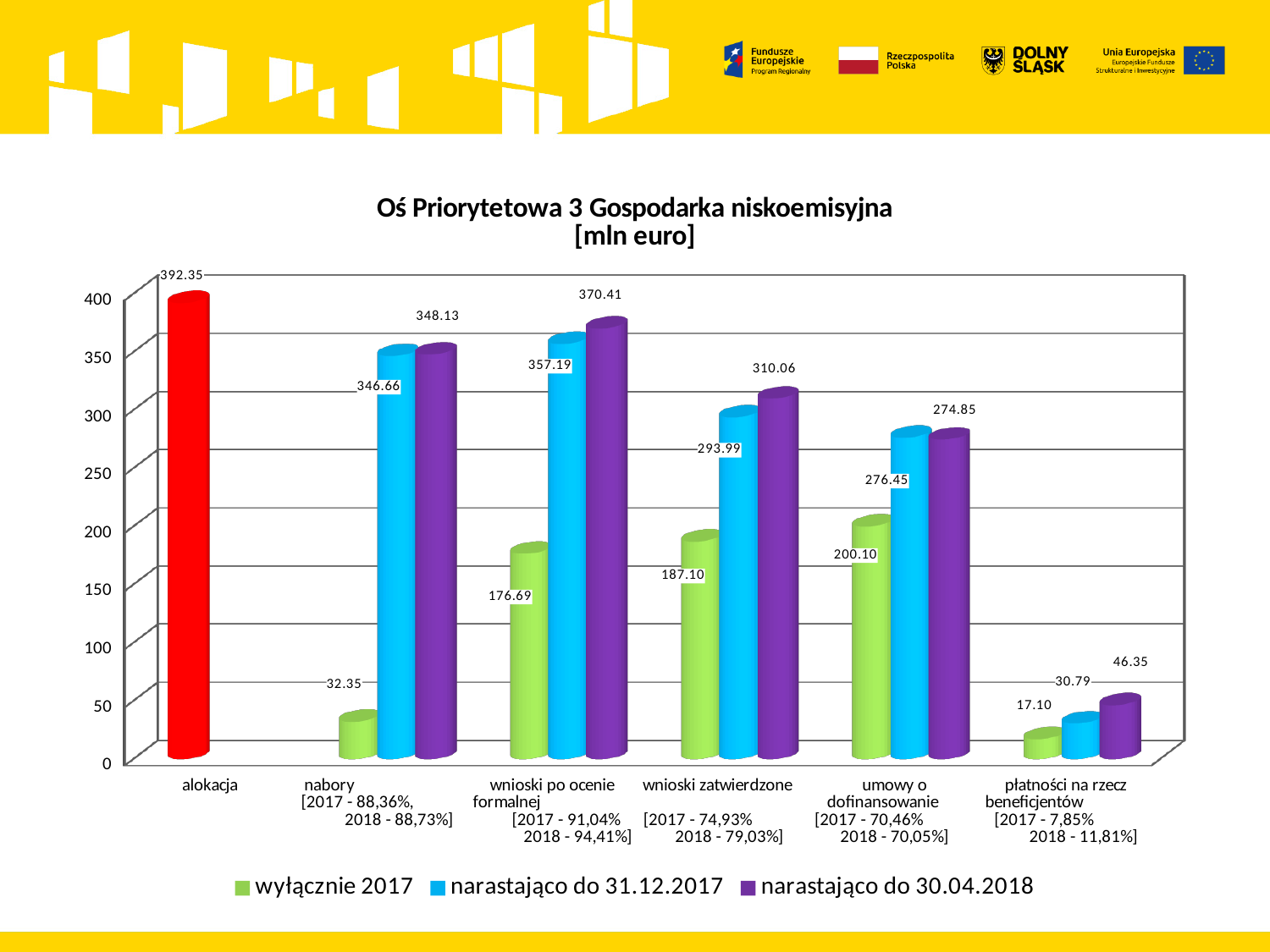
What unit is given in the chart title? mln euro How many categories are shown on the x axis? 6 How many series does the legend list? 3 What kind of chart is shown on the slide? bar chart What is the value for 'narastająco do 30.04.2018' in the 'wnioski po ocenie formalnej' category? 370.41 Which category has the lowest value for the 'wyłącznie 2017' series? płatności na rzecz beneficjentów What is the difference between the 'narastająco do 30.04.2018' and 'narastająco do 31.12.2017' values for 'wnioski zatwierdzone'? 16.07 Which category has the highest value for the 'narastająco do 30.04.2018' series? wnioski po ocenie formalnej In the 'nabory' category, which is larger: the 'wyłącznie 2017' value or the 'narastająco do 31.12.2017' value? narastająco do 31.12.2017 What is the value of the red 'alokacja' bar? 392.35 What is the value for 'narastająco do 31.12.2017' in the 'płatności na rzecz beneficjentów' category? 30.79 What is the value for 'wyłącznie 2017' in the 'umowy o dofinansowanie' category? 200.10